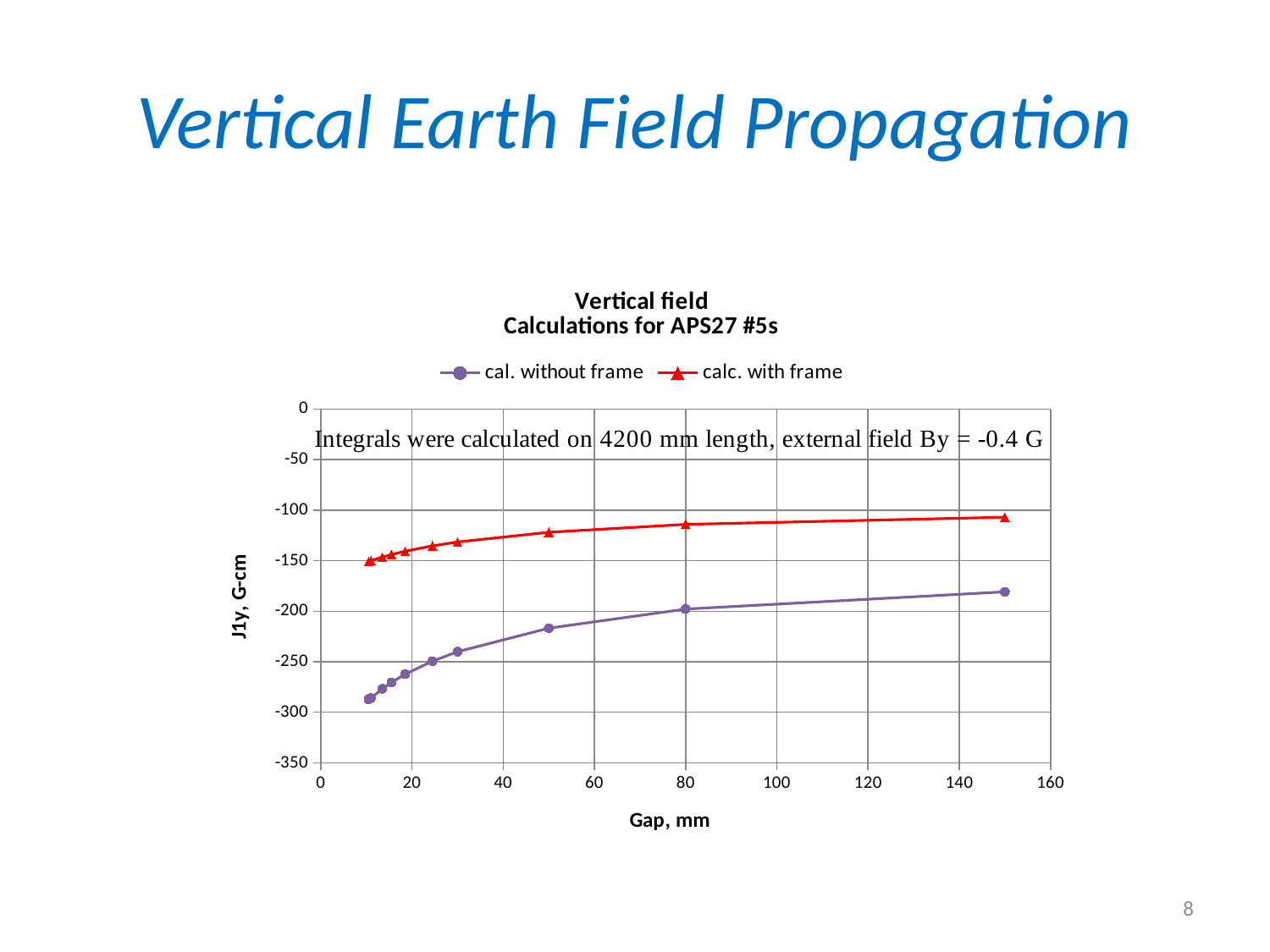
Which series is plotted with red triangle markers? calc. with frame Is the value for cal. without frame at a gap of 150 mm greater or less than -200? greater What is the label of the y axis? J1y, G-cm At a gap of 150 mm, which series has the higher (less negative) value, cal. without frame or calc. with frame? calc. with frame Do the values for cal. without frame rise or fall as the gap increases? rise Which series has the lowest value on the chart? cal. without frame Is the value for calc. with frame at a gap of 50 mm greater or less than -100? less Is the value for cal. without frame at a gap of 10 mm greater or less than -250? less How many series does the legend list? 2 What kind of chart is shown on the slide? line chart